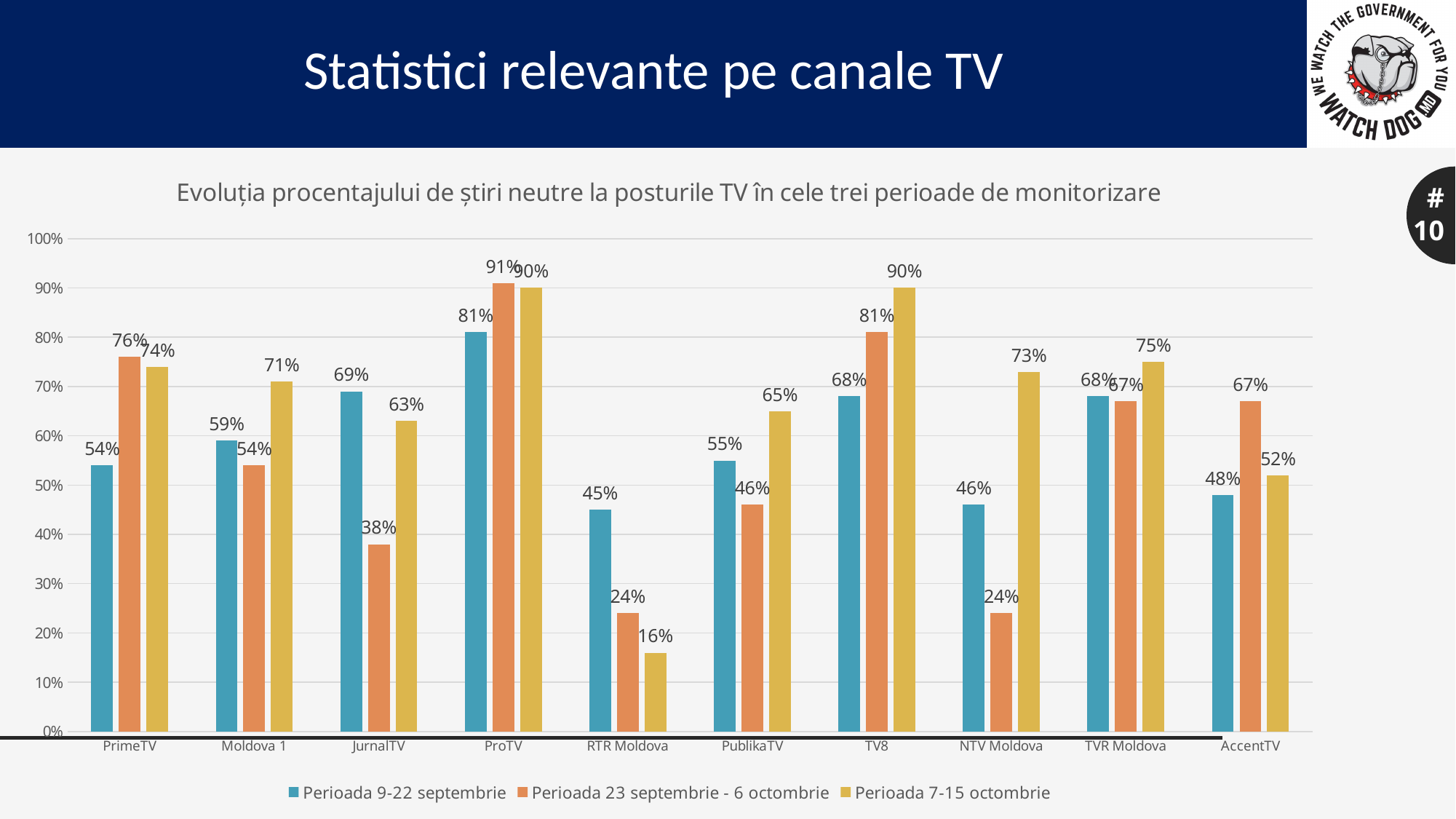
How many TV channels are shown on the x axis of the chart? 10 What is the value for NTV Moldova in the series 'Perioada 7-15 octombrie'? 73% Which TV channel has the lowest value in the series 'Perioada 7-15 octombrie'? RTR Moldova Do the values for RTR Moldova rise or fall across the three monitoring periods? Fall What is the title of the chart? Evoluția procentajului de știri neutre la posturile TV în cele trei perioade de monitorizare Which TV channel has the highest value in the series 'Perioada 9-22 septembrie'? ProTV What is the difference between the 'Perioada 7-15 octombrie' and 'Perioada 23 septembrie - 6 octombrie' values for NTV Moldova? 49% What is the value for ProTV in the series 'Perioada 23 septembrie - 6 octombrie'? 91% What is the value for JurnalTV in the series 'Perioada 9-22 septembrie'? 69% Which is larger for AccentTV: the value for 'Perioada 23 septembrie - 6 octombrie' or the value for 'Perioada 7-15 octombrie'? Perioada 23 septembrie - 6 octombrie How many series does the legend list? 3 What kind of chart is shown on the slide? Bar chart